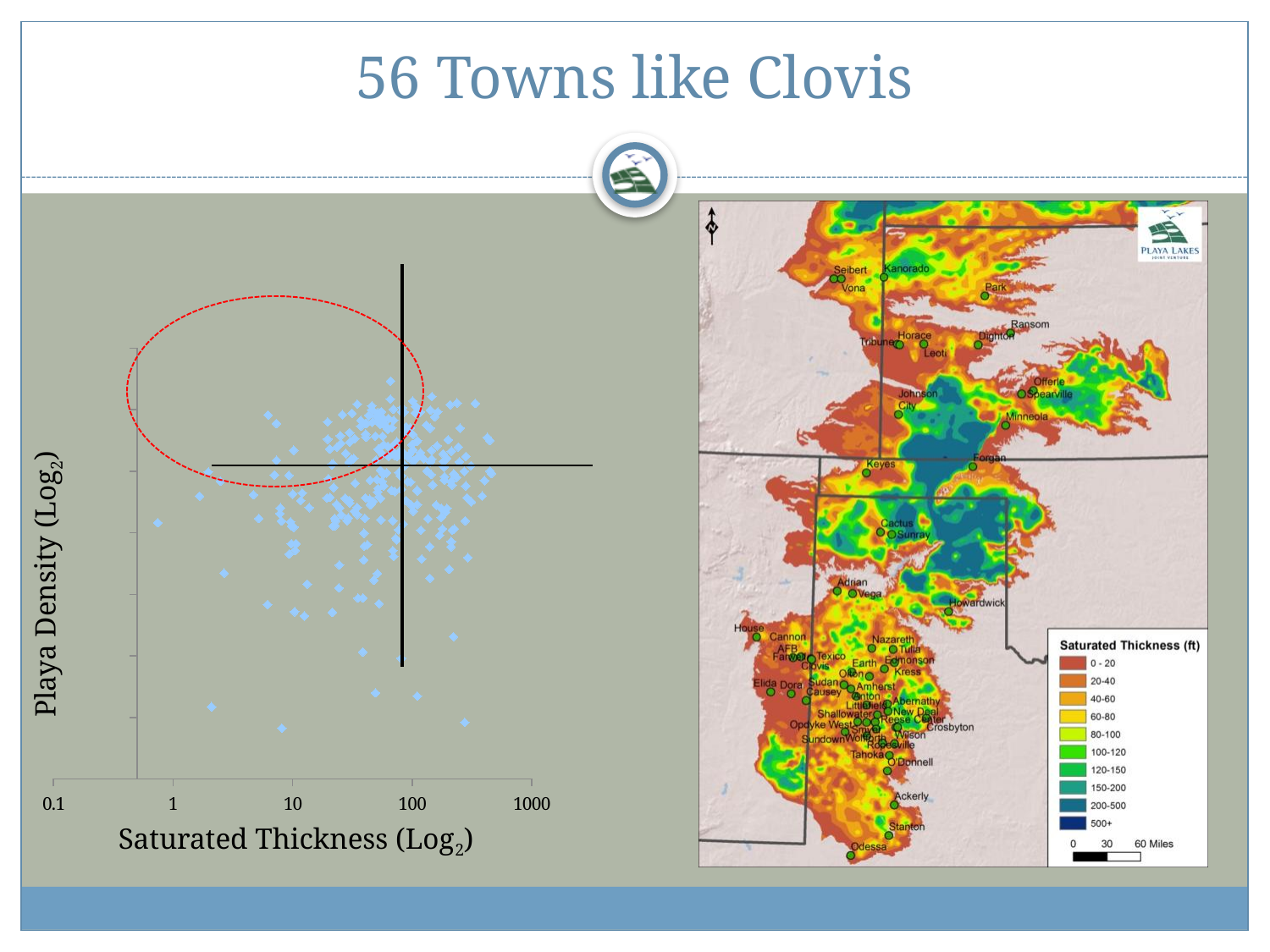
In the scatter plot, is the vertical black reference line positioned at a saturated thickness greater or less than 10? greater What is the label of the y axis of the scatter plot? Playa Density (Log2) What is the smallest tick value printed on the x axis of the scatter plot? 0.1 What is the largest tick value printed on the x axis of the scatter plot? 1000 In the scatter plot, are the majority of the data points located at a saturated thickness greater or less than 1? greater How many tick labels are printed on the x axis of the scatter plot? 5 What is the label of the x axis of the scatter plot? Saturated Thickness (Log2) What kind of chart is shown on the left of the slide? Scatter plot In the scatter plot, is the vertical black reference line positioned at a saturated thickness greater or less than 100? less